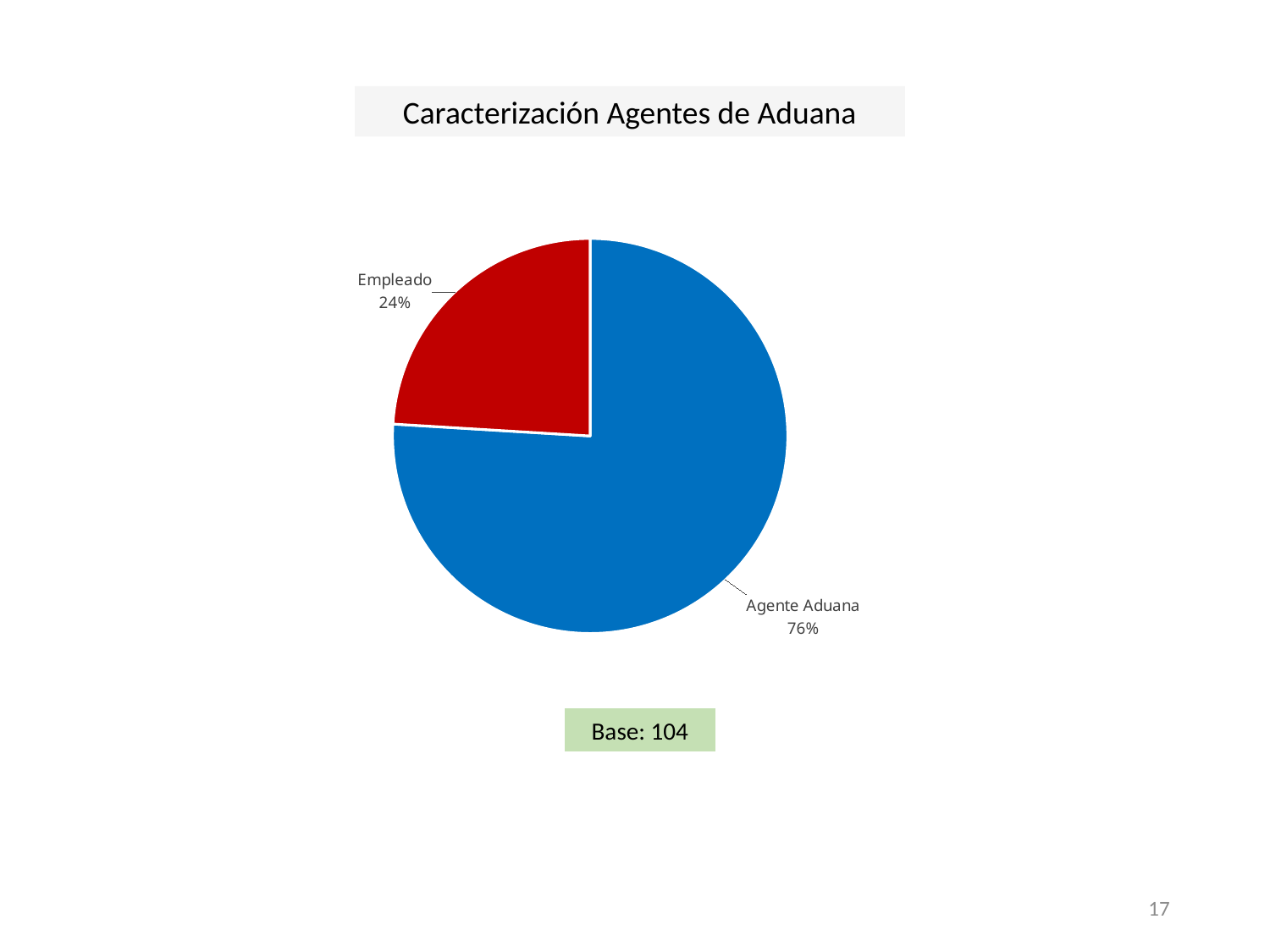
How many slices does the pie chart have? 2 What type of chart is shown on the slide? pie chart Which slice is larger, Empleado or Agente Aduana? Agente Aduana What percentage of the pie is labelled Empleado? 24% Which slice of the pie is the largest? Agente Aduana Which slice of the pie is the smallest? Empleado What colour is the Empleado slice? red What percentage of the pie is labelled Agente Aduana? 76% What is the title of the chart? Caracterización Agentes de Aduana What is the difference in percentage points between the Agente Aduana slice and the Empleado slice? 52 What is the base (sample size) shown below the chart? 104